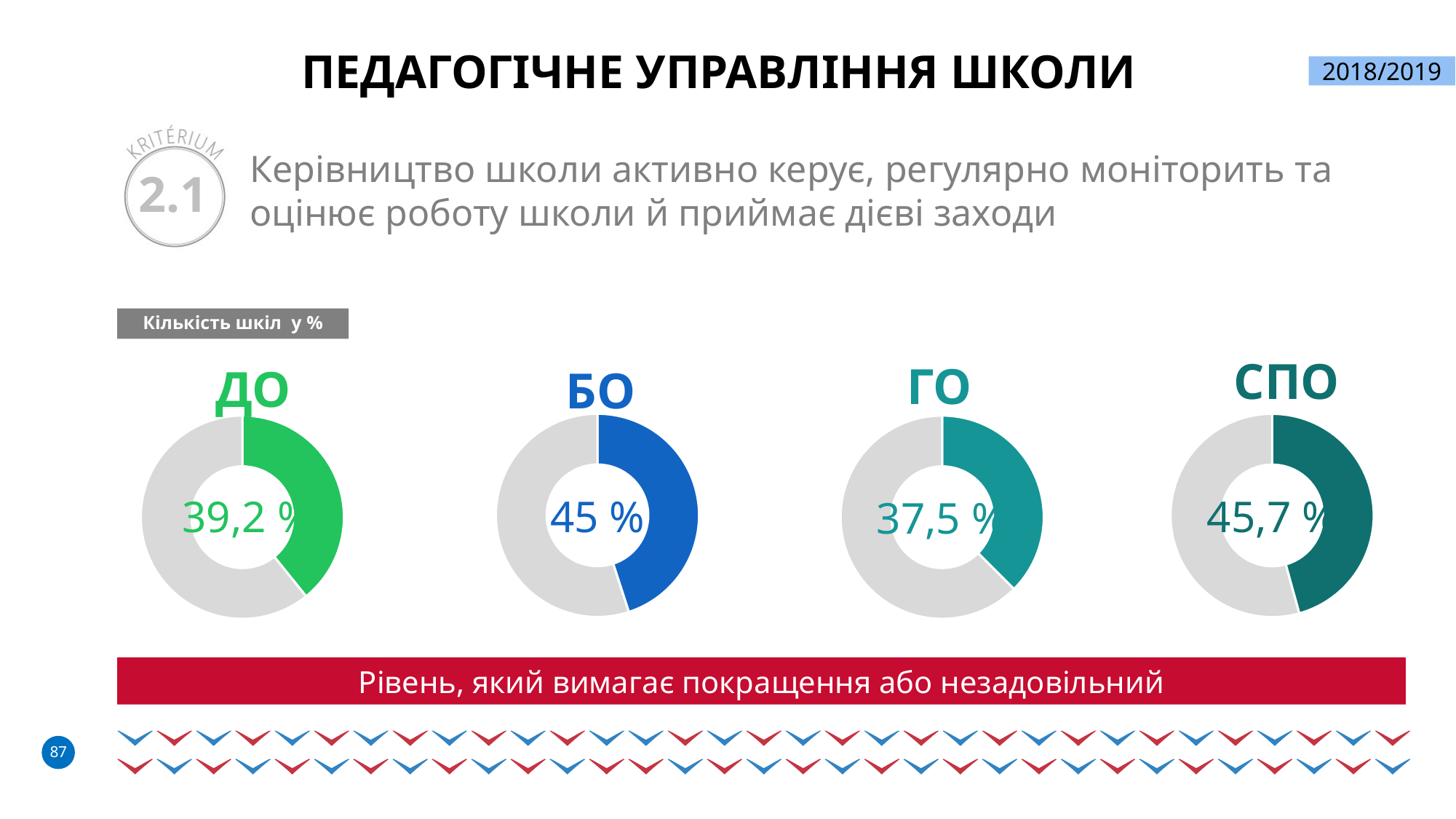
Which of the four donut charts shows the lowest percentage? ГО What is the difference between the values shown in the СПО and ГО donut charts? 8,2 % What is the difference between the values shown in the БО and ДО donut charts? 5,8 % What value is shown in the ДО donut chart? 39,2 % Which of the four donut charts shows the highest percentage? СПО Which shows a larger value, the ДО donut chart or the БО donut chart? БО What value is shown in the БО donut chart? 45 % What value is shown in the ГО donut chart? 37,5 % What colour is the highlighted segment of the ДО donut chart? Green How many donut charts are on the slide? 4 What value is shown in the СПО donut chart? 45,7 % What kind of chart is used for ДО, БО, ГО and СПО? Donut chart